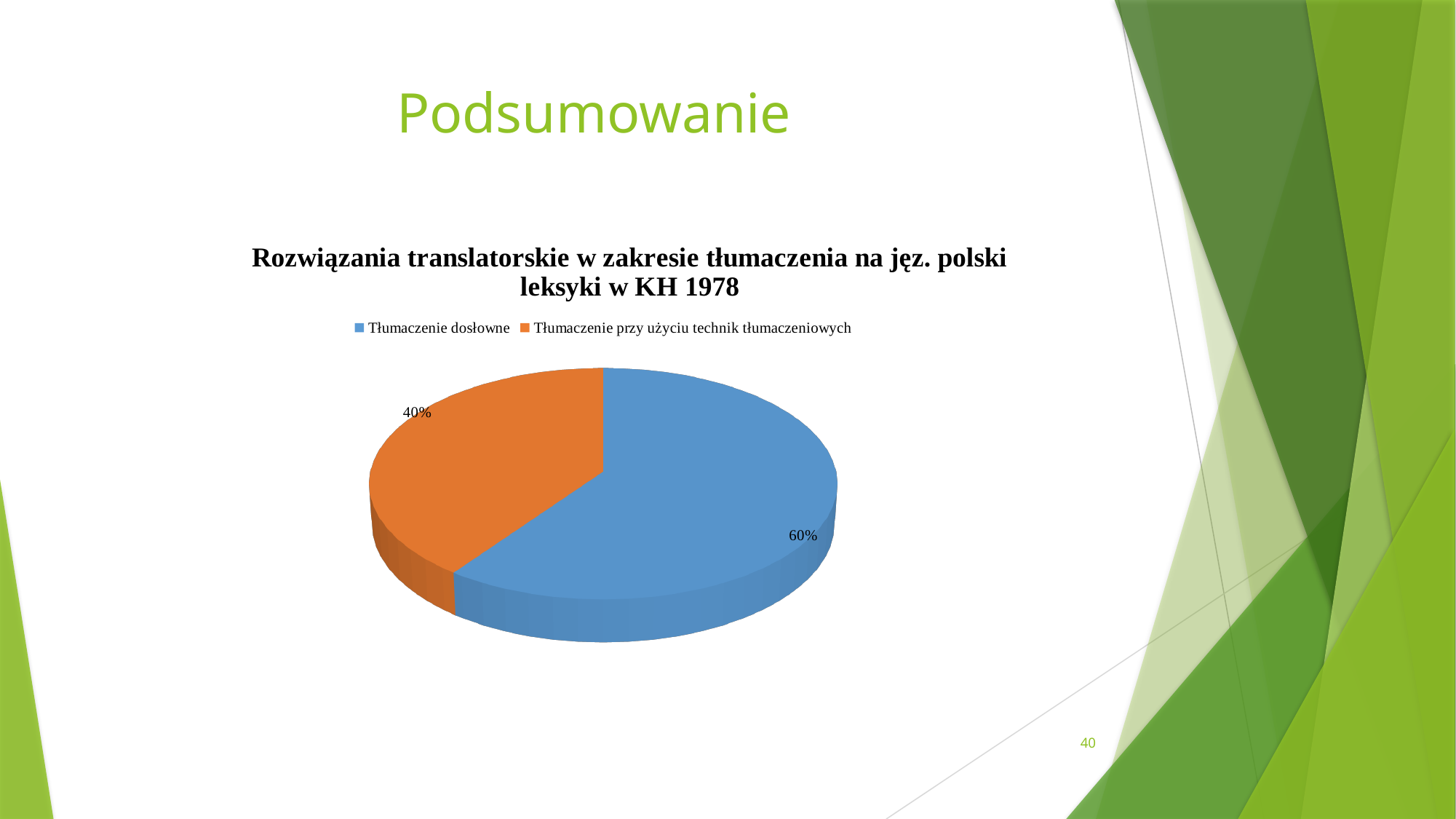
What share of the pie does "Tłumaczenie przy użyciu technik tłumaczeniowych" have? 40% What is the title of the chart? Rozwiązania translatorskie w zakresie tłumaczenia na jęz. polski leksyki w KH 1978 What share of the pie does "Tłumaczenie dosłowne" have? 60% Which category has the largest slice of the pie? Tłumaczenie dosłowne How many entries does the chart legend list? 2 Which is larger: the slice for "Tłumaczenie dosłowne" or the slice for "Tłumaczenie przy użyciu technik tłumaczeniowych"? Tłumaczenie dosłowne What kind of chart is shown on the slide? Pie chart How many slices does the pie chart have? 2 What is the difference in percentage points between the "Tłumaczenie dosłowne" slice and the "Tłumaczenie przy użyciu technik tłumaczeniowych" slice? 20 percentage points Which category has the smallest slice of the pie? Tłumaczenie przy użyciu technik tłumaczeniowych What colour is the slice for "Tłumaczenie przy użyciu technik tłumaczeniowych"? Orange